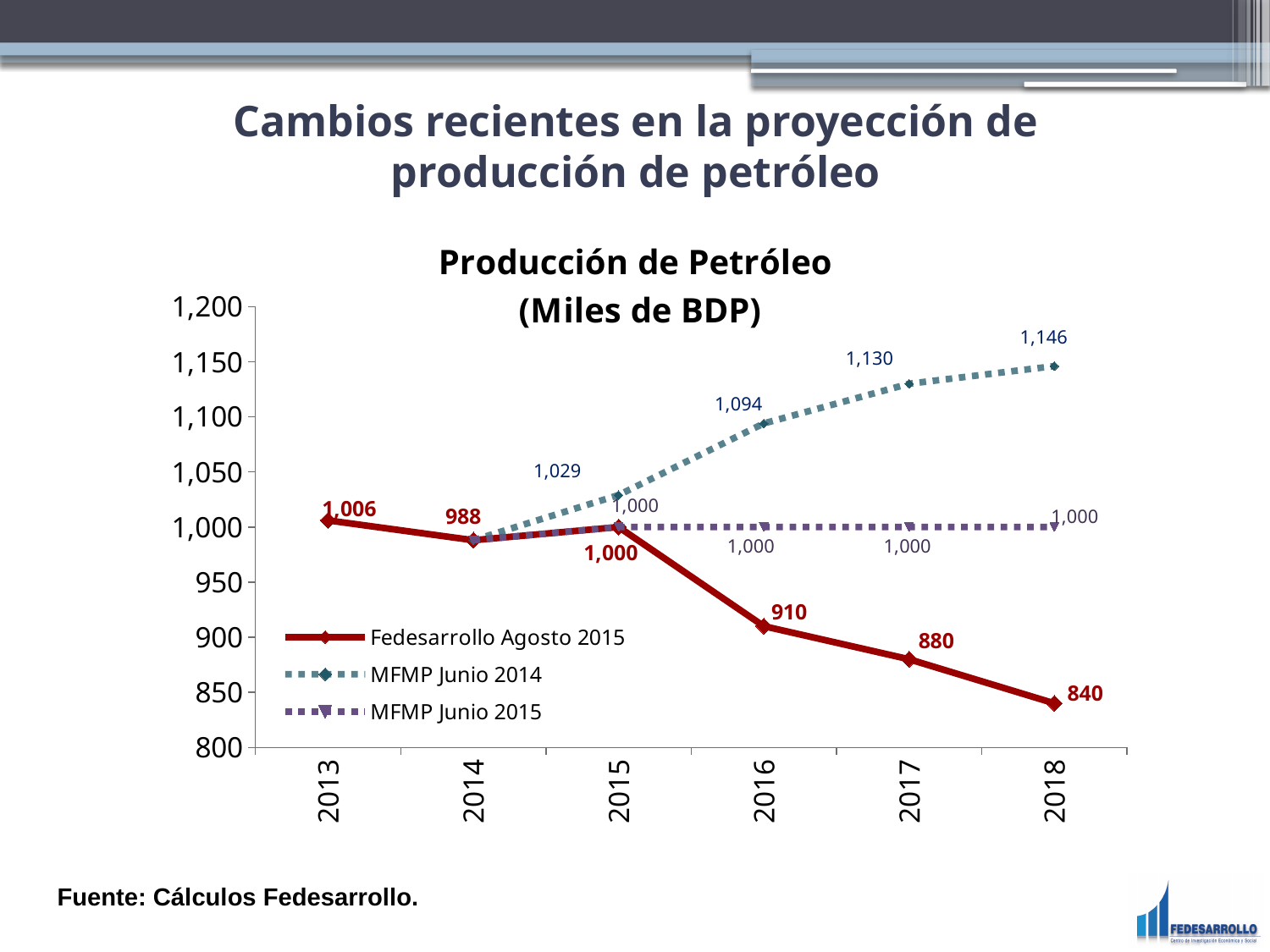
Does the Fedesarrollo Agosto 2015 series rise or fall from 2015 to 2018? fall How many series does the legend list? 3 In which year is the Fedesarrollo Agosto 2015 series lowest? 2018 What type of chart is shown on the slide? line chart What is the value for Fedesarrollo Agosto 2015 in 2013? 1,006 What is the value for MFMP Junio 2015 in 2018? 1,000 Which series has the larger value in 2016, MFMP Junio 2014 or Fedesarrollo Agosto 2015? MFMP Junio 2014 What is the value for Fedesarrollo Agosto 2015 in 2018? 840 What is the difference between MFMP Junio 2014 and Fedesarrollo Agosto 2015 in 2018? 306 What is the value for MFMP Junio 2014 in 2017? 1,130 In which year is the MFMP Junio 2014 series highest? 2018 What is the title of the chart? Producción de Petróleo (Miles de BDP)